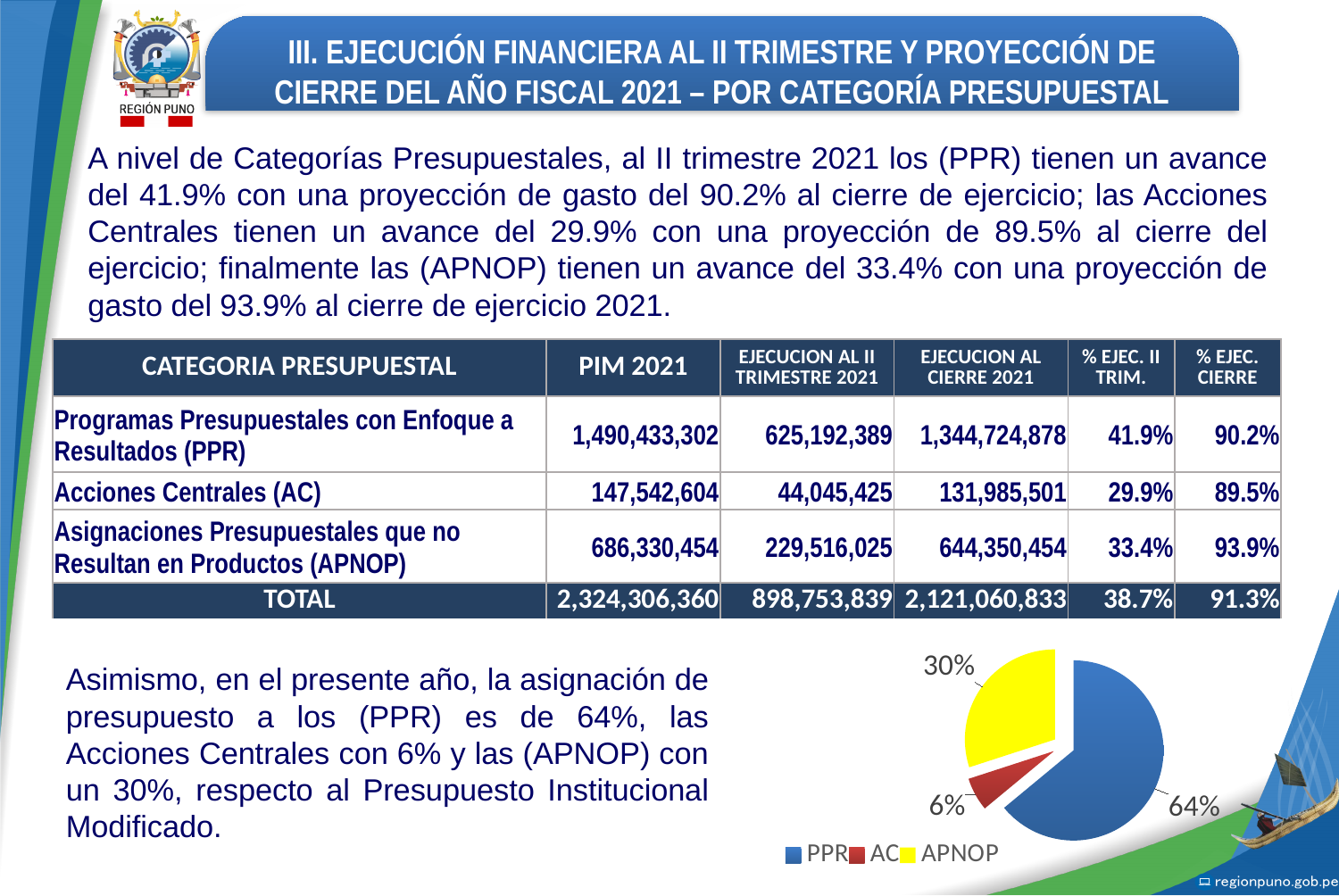
What share of the pie chart does AC represent? 6% What colour is the APNOP slice in the pie chart? Yellow Which slice is larger in the pie chart, APNOP or AC? APNOP What kind of chart is shown at the bottom right of the slide? Pie chart Which category has the smallest slice in the pie chart? AC Which category is shown in red in the pie chart? AC What share of the pie chart does APNOP represent? 30% What is the difference in percentage points between the PPR slice and the APNOP slice in the pie chart? 34 How many entries does the legend of the pie chart list? 3 How many slices does the pie chart have? 3 What share of the pie chart does PPR represent? 64% Which category has the largest slice in the pie chart? PPR